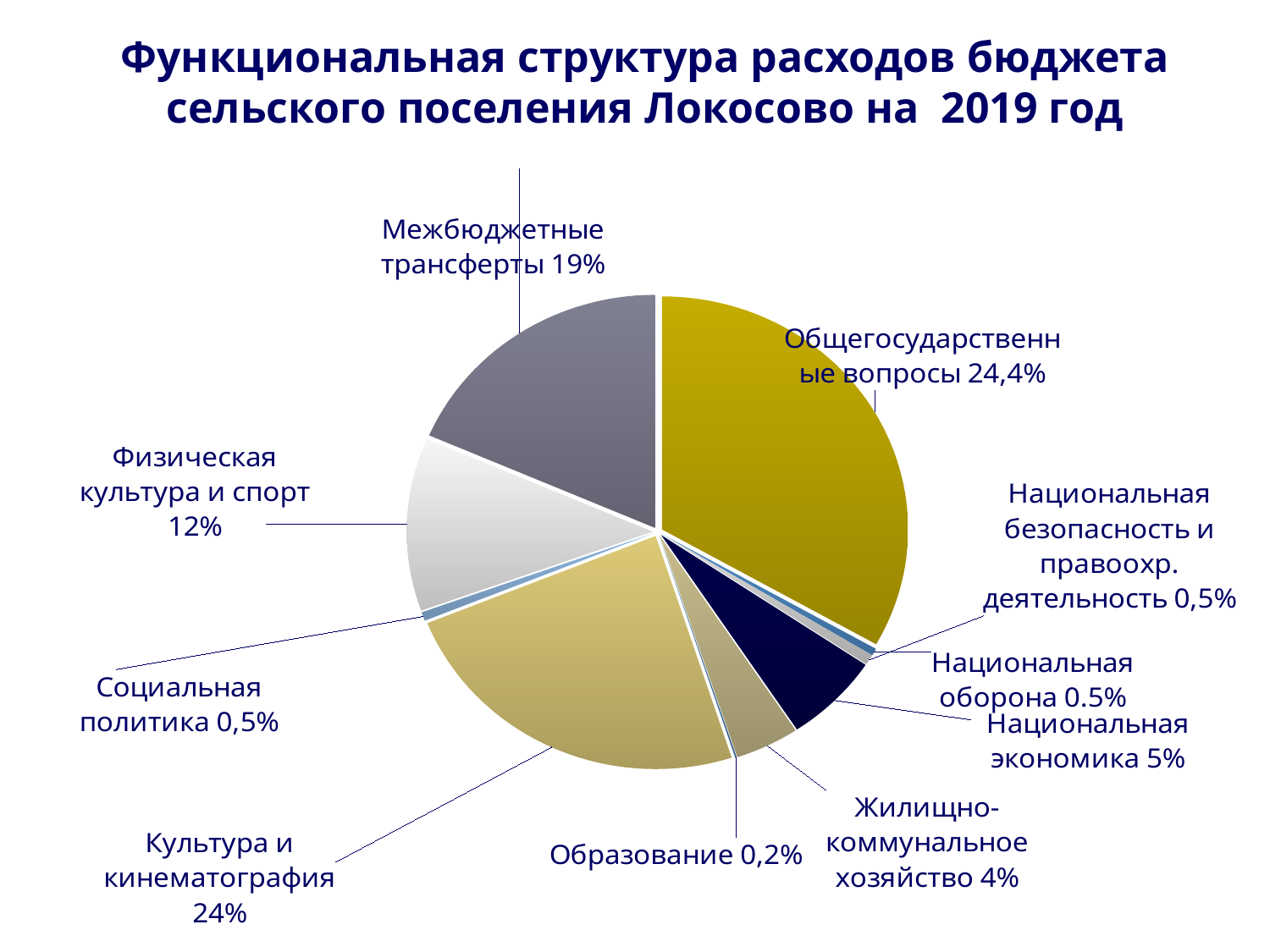
Which category has the largest share of the pie? Общегосударственные вопросы What is the difference in percentage points between Культура и кинематография and Физическая культура и спорт? 12 What year does the chart title refer to? 2019 What share is labelled for Межбюджетные трансферты? 19% What share of the budget expenditure goes to Общегосударственные вопросы? 24,4% Which category has the smallest share of the pie? Образование What share is labelled for Национальная экономика? 5% What kind of chart is shown on the slide? pie chart Which is larger: the share for Национальная экономика or the share for Жилищно-коммунальное хозяйство? Национальная экономика What share is labelled for Жилищно-коммунальное хозяйство? 4% What share is labelled for Физическая культура и спорт? 12% How many slices does the pie chart have? 10